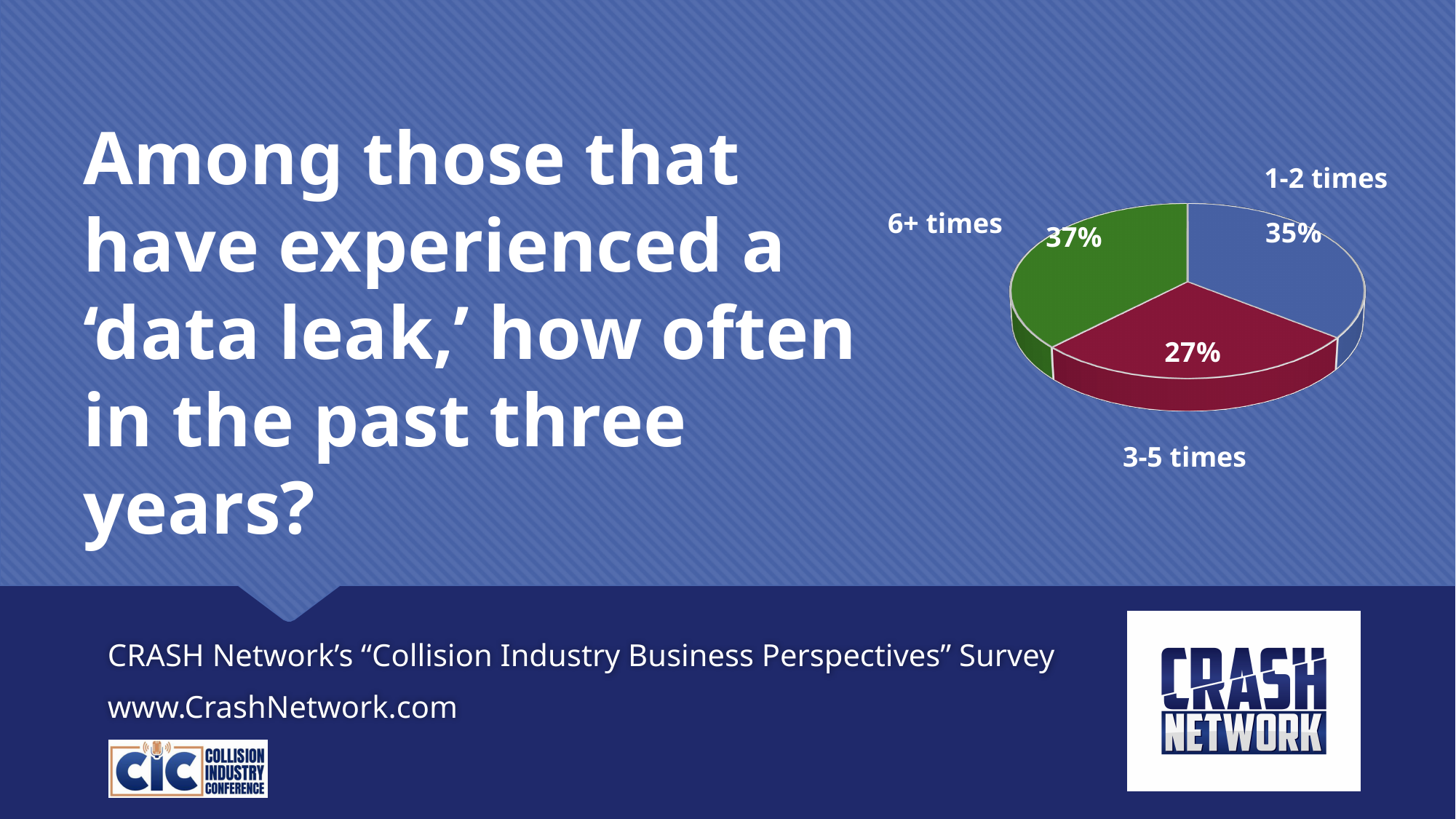
Which category has the smallest share of the pie? 3-5 times What colour is the slice for 3-5 times? red What is the difference in percentage points between the 1-2 times slice and the 3-5 times slice? 8 How many categories are shown in the pie chart? 3 What colour is the slice for 6+ times? green Which category has the largest share of the pie? 6+ times What percentage of respondents experienced a data leak 3-5 times? 27% What is the difference in percentage points between the 6+ times slice and the 3-5 times slice? 10 What kind of chart is shown on the slide? pie chart What percentage of respondents experienced a data leak 1-2 times? 35% Which is larger, the share for 1-2 times or the share for 3-5 times? 1-2 times What percentage of respondents experienced a data leak 6+ times? 37%